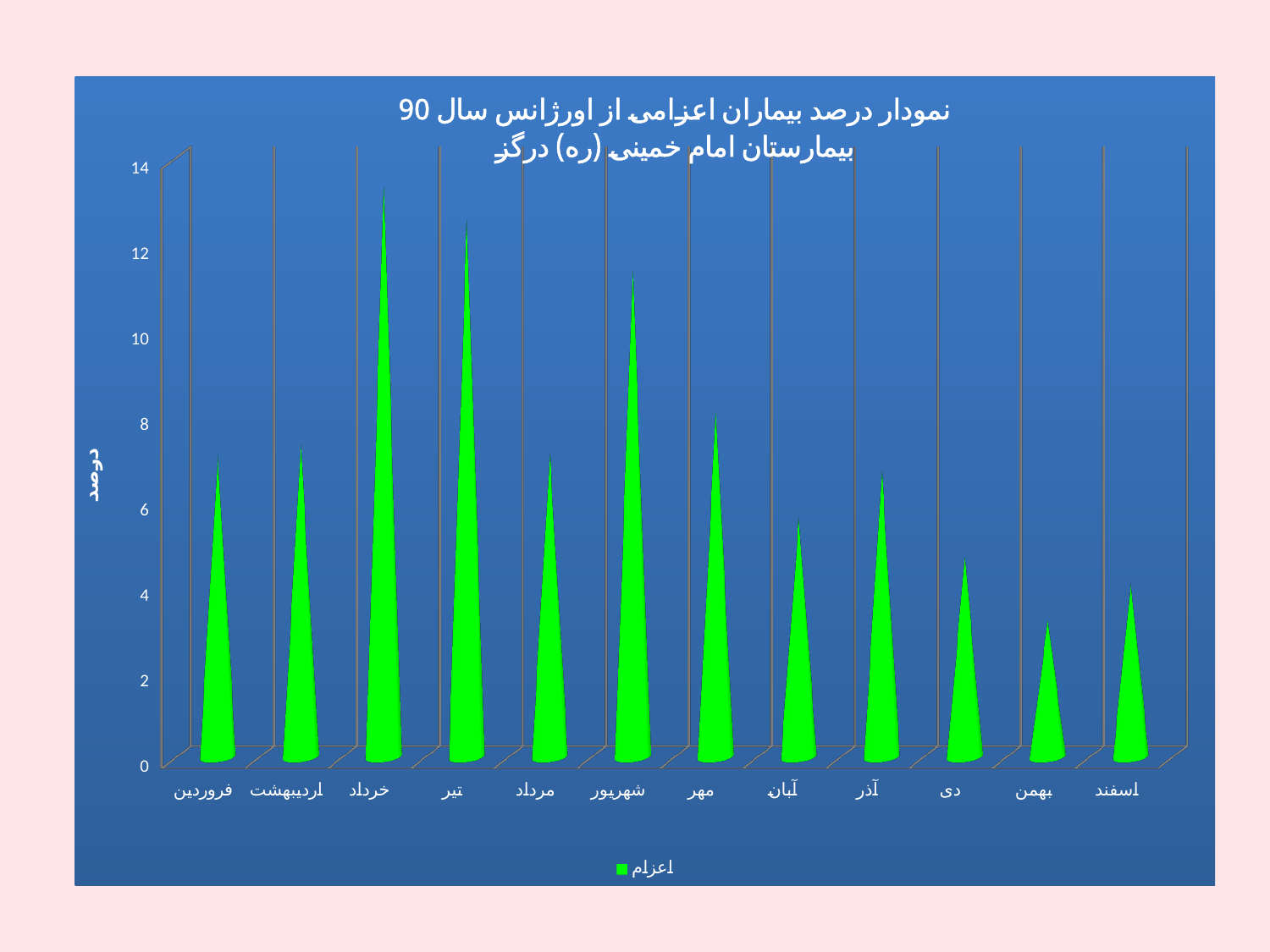
How many series does the legend list? 1 Do the values rise or fall from آذر to بهمن? fall Which is larger, the value for شهریور or the value for مهر? شهریور Which month has the lowest value? بهمن Is the value for خرداد greater or less than 12? greater Which month has the highest value? خرداد Is the value for شهریور greater or less than 10? greater What is the legend entry for the series? اعزام How many categories (months) are shown on the x axis? 12 What kind of chart is shown on the slide? bar chart Is the value for بهمن greater or less than 4? less